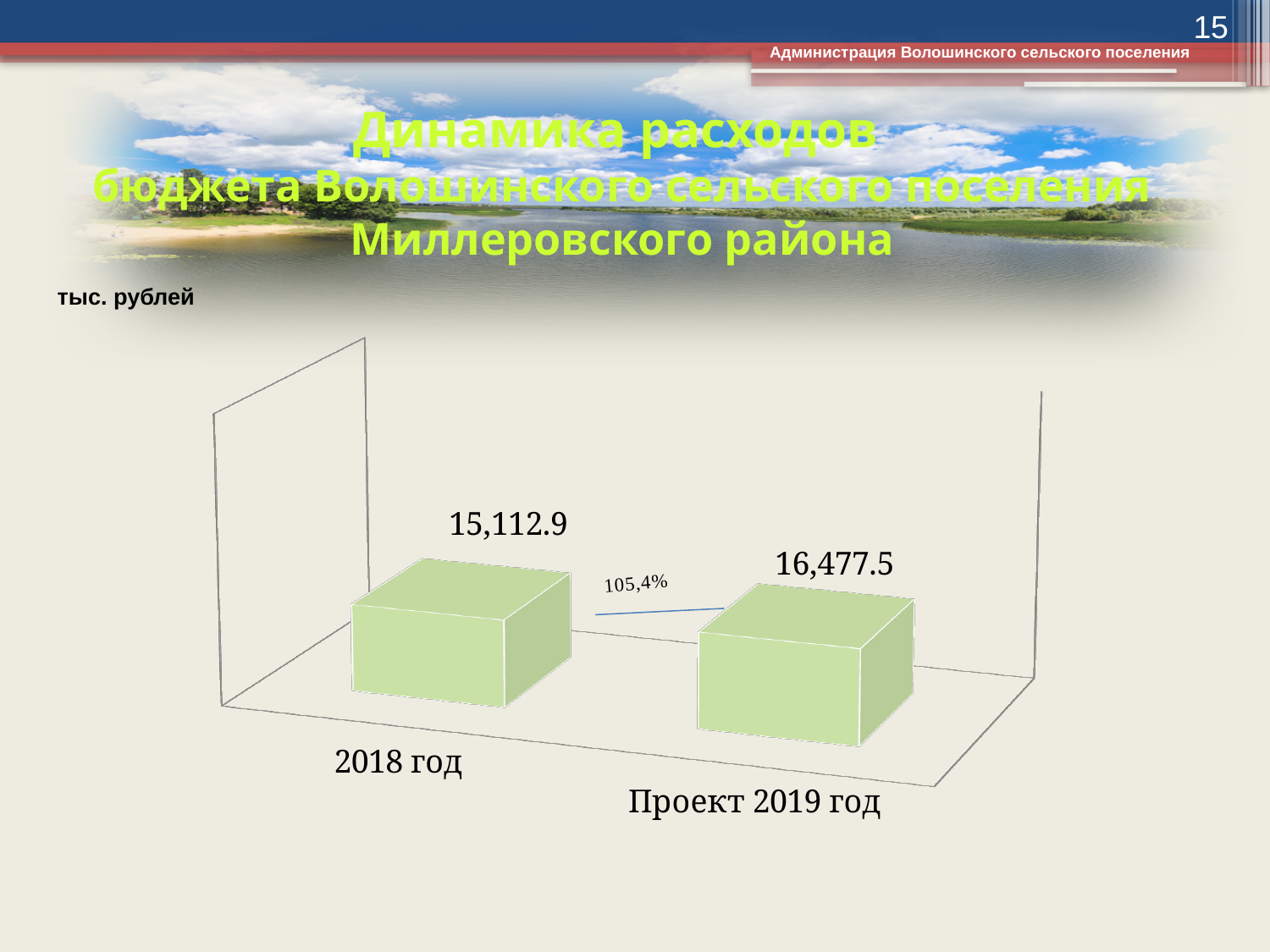
What is the difference between the values for Проект 2019 год and 2018 год? 1,364.6 What is the value for Проект 2019 год? 16,477.5 How many categories are shown in the chart? 2 What is the value for 2018 год? 15,112.9 What kind of chart is shown on the slide? bar chart Which is larger, the value for 2018 год or the value for Проект 2019 год? Проект 2019 год Which category has the lowest value? 2018 год What percentage is printed on the connector between the two bars? 105,4% What unit of measurement is stated above the chart? тыс. рублей Which category has the highest value? Проект 2019 год Do the values rise or fall from 2018 год to Проект 2019 год? rise